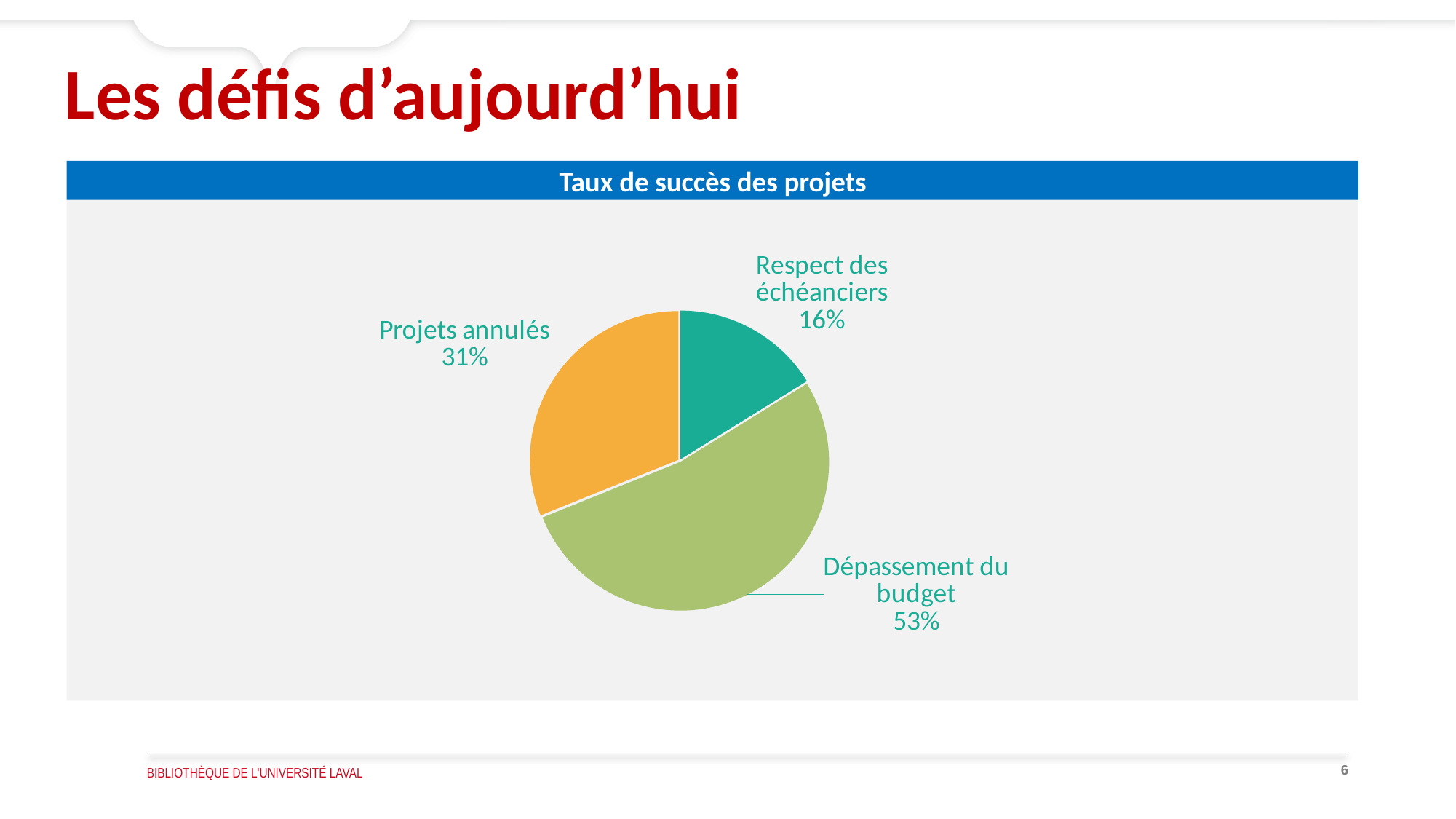
Which is larger: the share for "Projets annulés" or the share for "Respect des échéanciers"? Projets annulés Which category has the smallest slice of the pie? Respect des échéanciers How many slices does the pie chart have? 3 What is the title of the chart? Taux de succès des projets What kind of chart is shown on the slide? Pie chart What share of the pie does "Projets annulés" represent? 31% What colour is the "Projets annulés" slice? Orange What is the difference in percentage points between "Projets annulés" and "Respect des échéanciers"? 15 What share of the pie does "Dépassement du budget" represent? 53% What share of the pie does "Respect des échéanciers" represent? 16% Which category has the largest slice of the pie? Dépassement du budget What is the difference in percentage points between "Dépassement du budget" and "Projets annulés"? 22